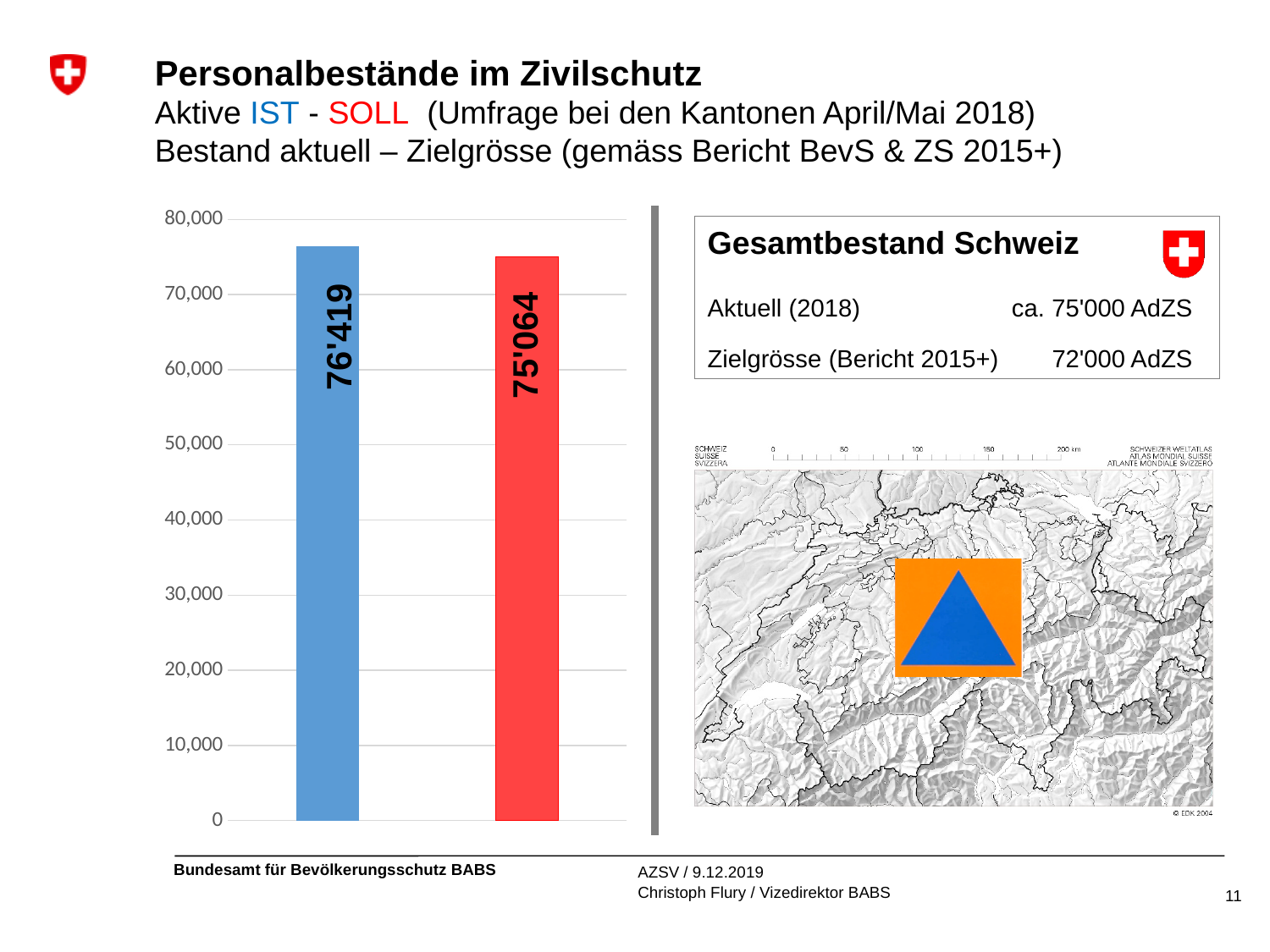
How many bars are plotted in the chart? 2 What value is shown on the red bar (SOLL) in the bar chart? 75'064 Is the value of the red (SOLL) bar greater or less than 70,000? greater Is the value of the blue (IST) bar greater or less than 80,000? less Which bar in the chart is taller, the blue (IST) bar or the red (SOLL) bar? the blue (IST) bar According to the slide subtitle, which colour represents the IST values in the chart? blue What is the difference between the blue bar value (76'419) and the red bar value (75'064)? 1'355 What value is shown on the blue bar (IST) in the bar chart? 76'419 What is the highest value labelled on the y-axis of the bar chart? 80,000 What kind of chart is shown on the left of the slide? bar chart Is the value of the blue (IST) bar larger or smaller than the value of the red (SOLL) bar? larger Which bar in the chart has the lower value, the blue (IST) bar or the red (SOLL) bar? the red (SOLL) bar